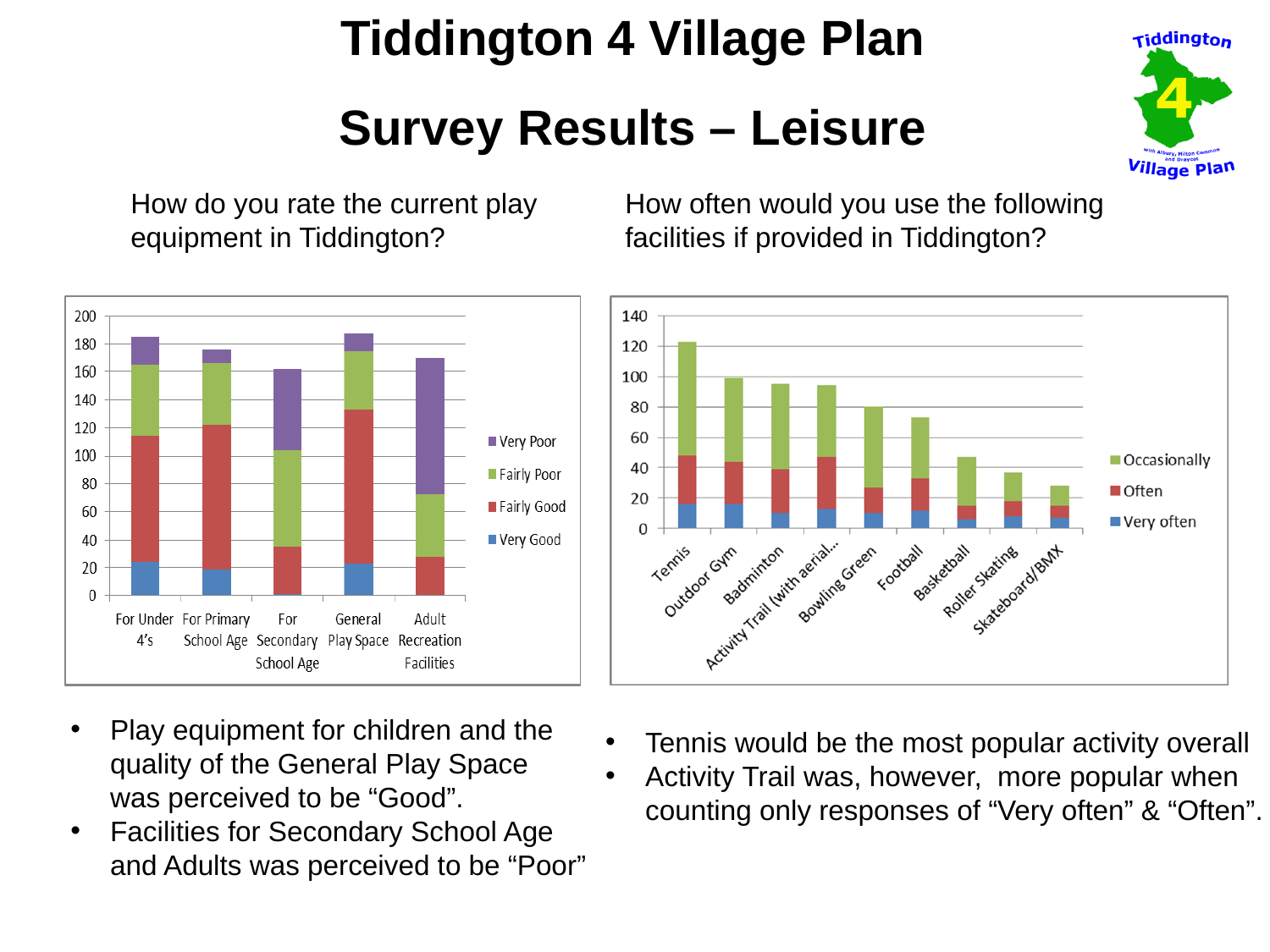
In the left chart about rating the current play equipment, is the total height of the bar for 'For Secondary School Age' greater or less than 180? less In the left chart about rating the current play equipment, is the total height of the bar for 'Adult Recreation Facilities' greater or less than 180? less In the right chart about how often facilities would be used, do the total bar heights rise or fall moving from left to right along the x axis? fall How many categories are shown on the x axis of the left chart about rating the current play equipment? 5 How many series does the legend list in the right chart about how often facilities would be used? 3 How many series does the legend list in the left chart about rating the current play equipment? 4 In the right chart about how often facilities would be used, which facility has the shortest total bar? Skateboard/BMX In the left chart about rating the current play equipment, which series is shown in purple? Very Poor In the right chart about how often facilities would be used, is the total bar for Tennis greater or less than 100? greater What kind of chart is the chart on the left, titled 'How do you rate the current play equipment in Tiddington?'? stacked bar chart How many categories are shown on the x axis of the right chart about how often facilities would be used? 9 In the right chart about how often facilities would be used, which facility has the tallest total bar? Tennis